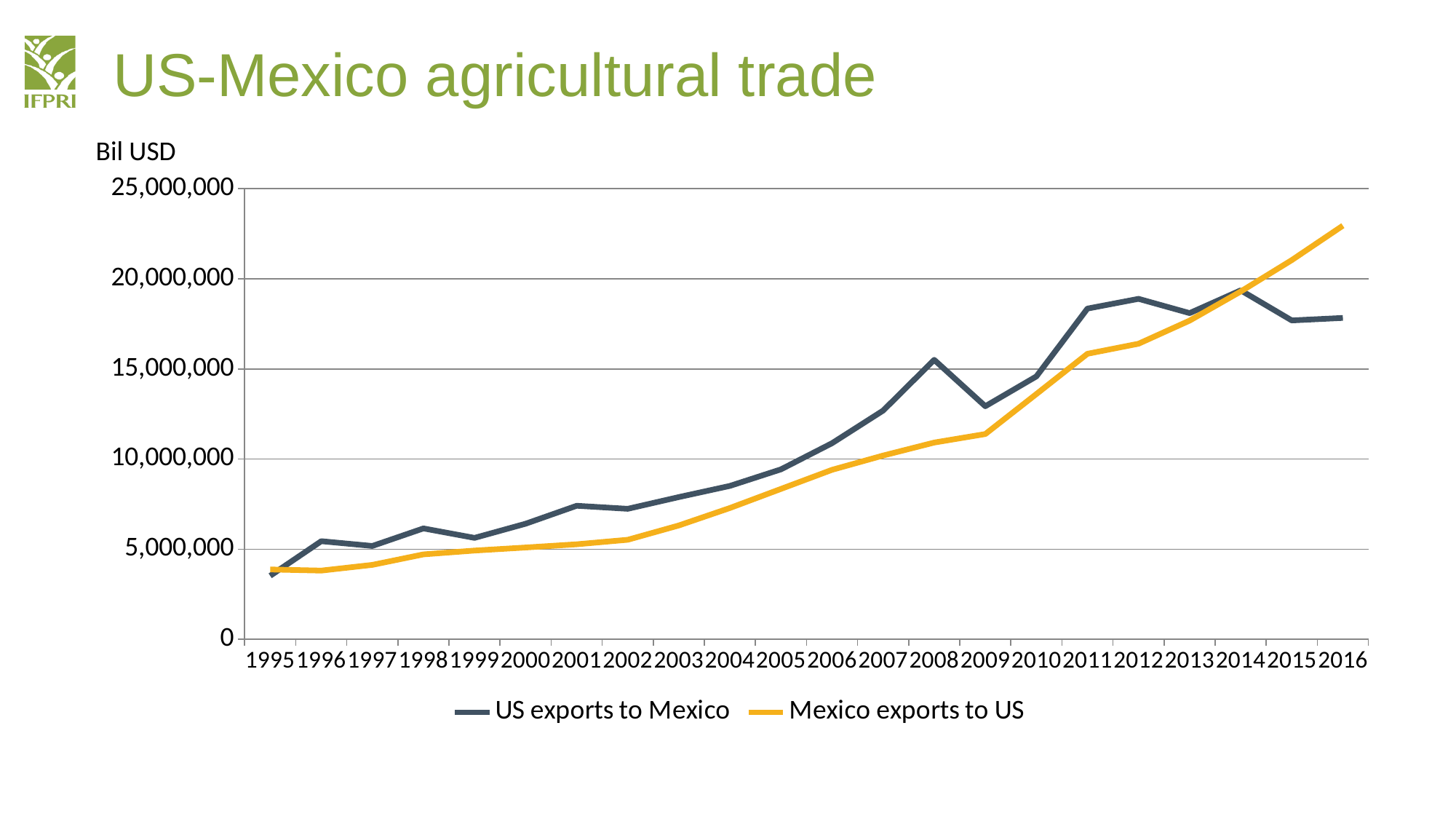
Which series has the higher value in 2016? Mexico exports to US In which year is US exports to Mexico at its lowest? 1995 Which series has the higher value in 2008? US exports to Mexico How many series does the legend list? 2 Is the value for Mexico exports to US in 2016 greater or less than 20,000,000? greater In which year is Mexico exports to US at its highest? 2016 What kind of chart is shown on the slide? Line chart Is the value for Mexico exports to US in 2005 greater or less than 10,000,000? less How many years are plotted along the x axis? 22 What unit label is shown above the y axis? Bil USD Is the value for US exports to Mexico in 2009 greater or less than 15,000,000? less Does Mexico exports to US generally rise or fall from 1995 to 2016? Rise